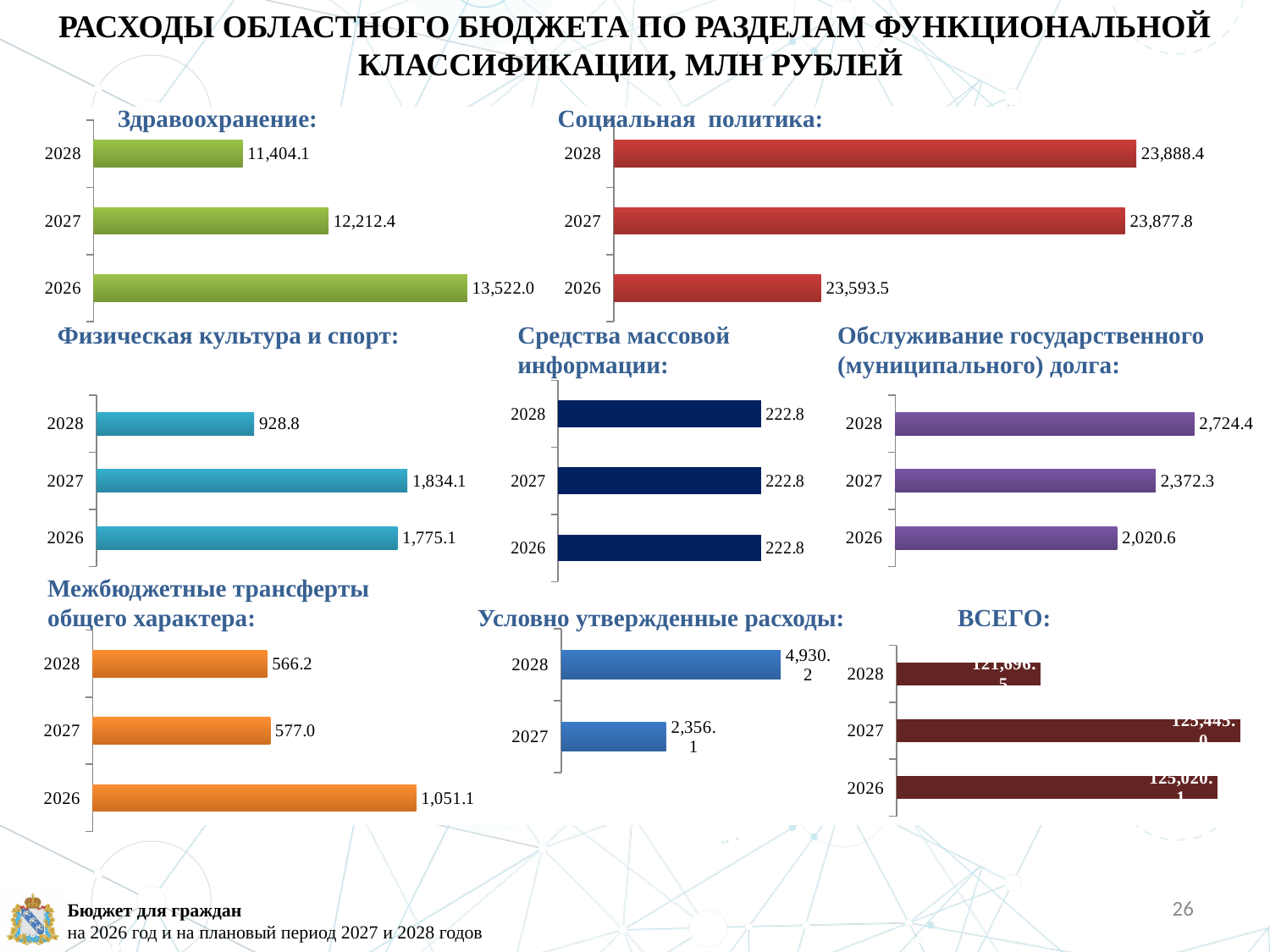
In the Физическая культура и спорт chart, which year has the highest value? 2027 In the Физическая культура и спорт chart, what is the value for 2028? 928.8 What type of chart is the Здравоохранение chart? bar chart How many years are shown in the Условно утвержденные расходы chart? 2 In the Здравоохранение chart, what is the value for 2026? 13,522.0 In the Социальная политика chart, what is the value for 2027? 23,877.8 In the Здравоохранение chart, which year has the lowest value? 2028 In the Обслуживание государственного (муниципального) долга chart, what is the difference between the 2028 and 2027 values? 352.1 In the Социальная политика chart, what is the difference between the 2028 and 2026 values? 294.9 In the Межбюджетные трансферты общего характера chart, which is larger, the value for 2027 or for 2028? 2027 In the Обслуживание государственного (муниципального) долга chart, do the values rise or fall from 2026 to 2028? rise In the Средства массовой информации chart, what is the value for 2027? 222.8